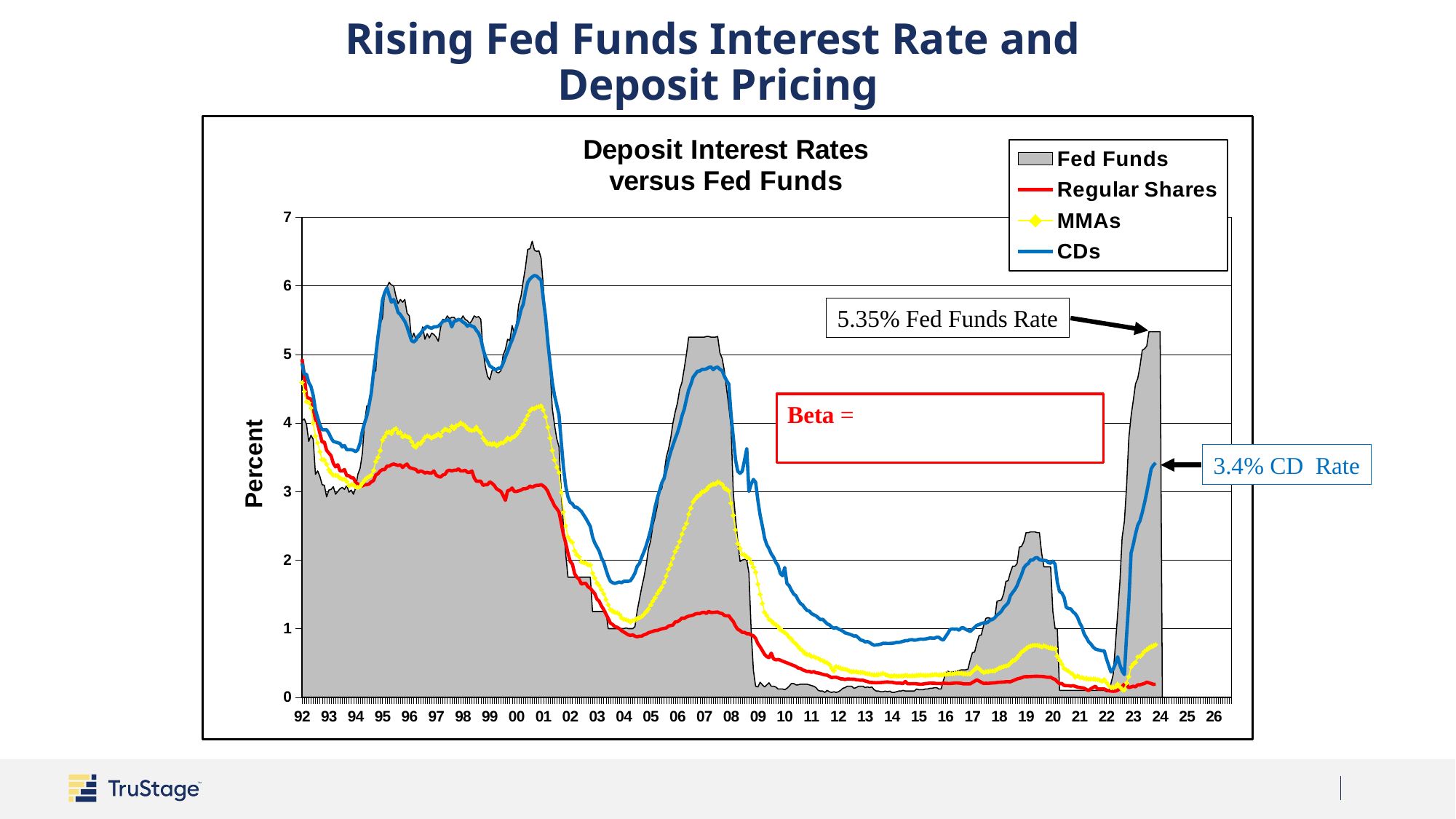
Is the CDs value around 2014 greater or less than 1? less How many series does the chart legend list? 4 Is the Fed Funds value at its peak around 2001 greater or less than 6? greater What is the title of the chart on the slide? Deposit Interest Rates versus Fed Funds Which series is highest at the right end of the chart (around 2024)? Fed Funds Is the CDs value around 2007 greater or less than 4? greater Does the Fed Funds series rise or fall between 2022 and 2024? rise What CD rate is called out by the annotation at the right end of the chart? 3.4% What Fed Funds rate is called out by the annotation at the right end of the chart? 5.35% What is the label on the vertical axis of the chart? Percent Around 2019, which is higher: CDs or Regular Shares? CDs Does the CDs series rise or fall between 2007 and 2010? fall